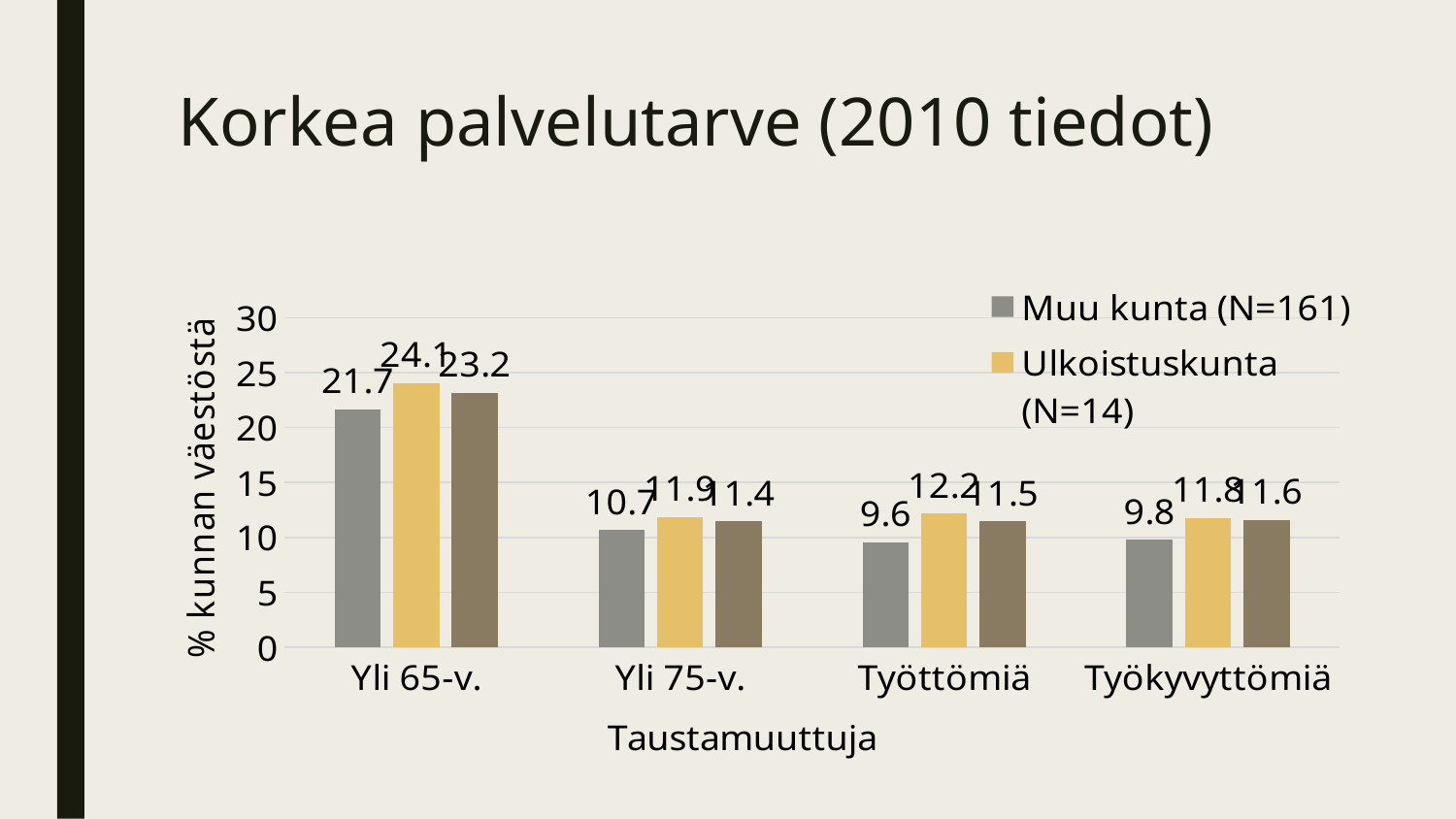
What is the value for Muu kunta (N=161) in the Yli 65-v. category? 21.7 What is the value for Ulkoistuskunta (N=14) in the Yli 65-v. category? 24.1 How many series does the legend list? 2 What is the value for Muu kunta (N=161) in the Yli 75-v. category? 10.7 Is the value for Muu kunta (N=161) in the Yli 65-v. category greater or less than 20? greater What kind of chart is shown on the slide? Bar chart Which category has the highest value for Muu kunta (N=161)? Yli 65-v. What is the difference between the Ulkoistuskunta (N=14) and Muu kunta (N=161) values in the Yli 65-v. category? 2.4 What is the value for Muu kunta (N=161) in the Työttömiä category? 9.6 How many categories are shown on the x axis? 4 In the Työttömiä category, which is larger: Muu kunta (N=161) or Ulkoistuskunta (N=14)? Ulkoistuskunta (N=14) Which category has the lowest value for Muu kunta (N=161)? Työttömiä